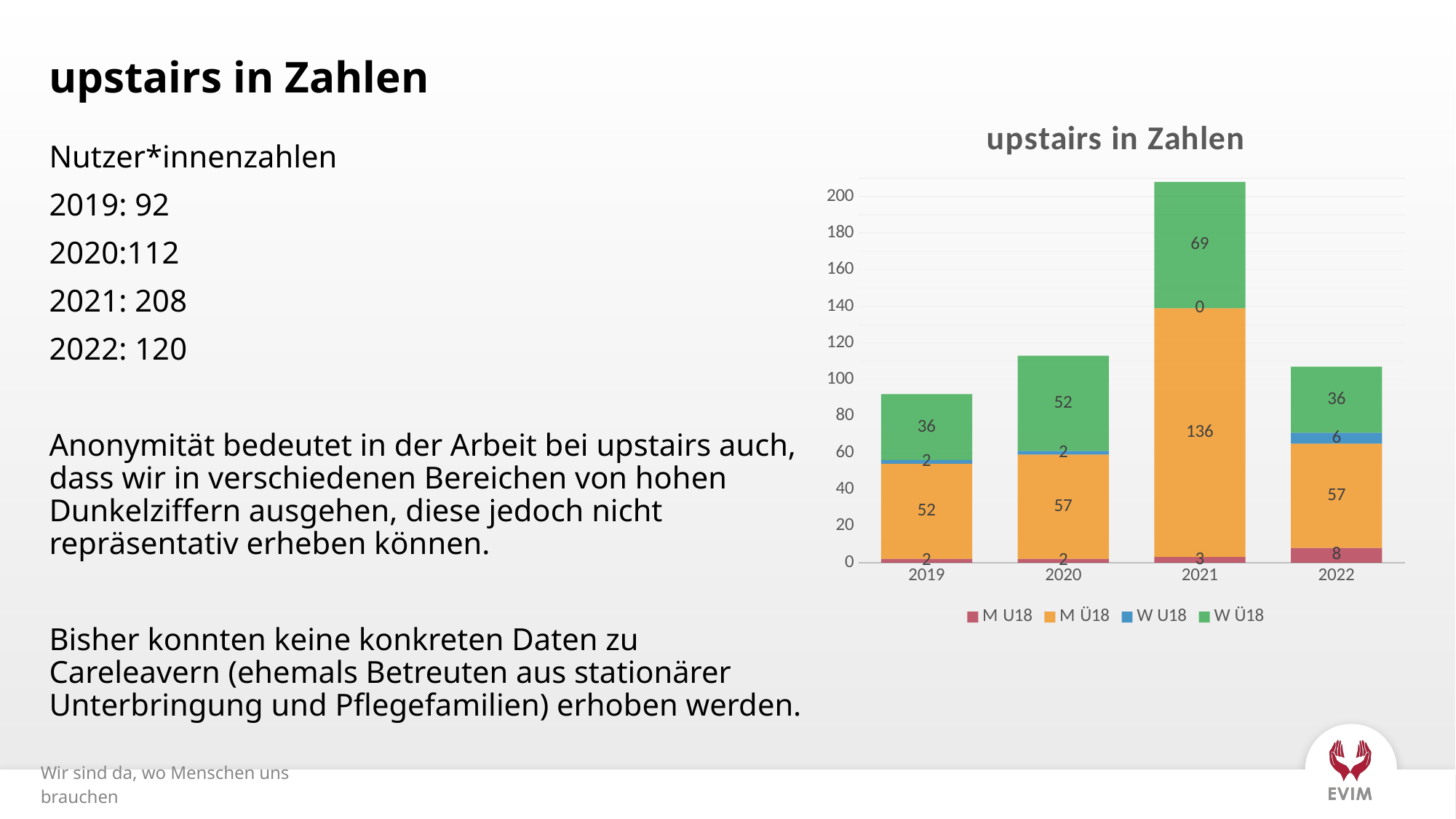
What is the difference between the M Ü18 value in 2021 and in 2020? 79 What is the total of the stacked bar for 2019? 92 Which is larger, the M Ü18 value in 2019 or in 2022? 2022 What is the value for M U18 in 2022? 8 Which year has the highest total bar in the chart? 2021 How many series does the legend of the chart list? 4 How many years are shown on the x axis of the chart? 4 What kind of chart is shown on the slide? stacked bar chart Is the total bar for 2022 greater or less than 100? greater What is the value for M Ü18 in 2021? 136 What is the value for W Ü18 in 2020? 52 What is the value for W U18 in 2021? 0